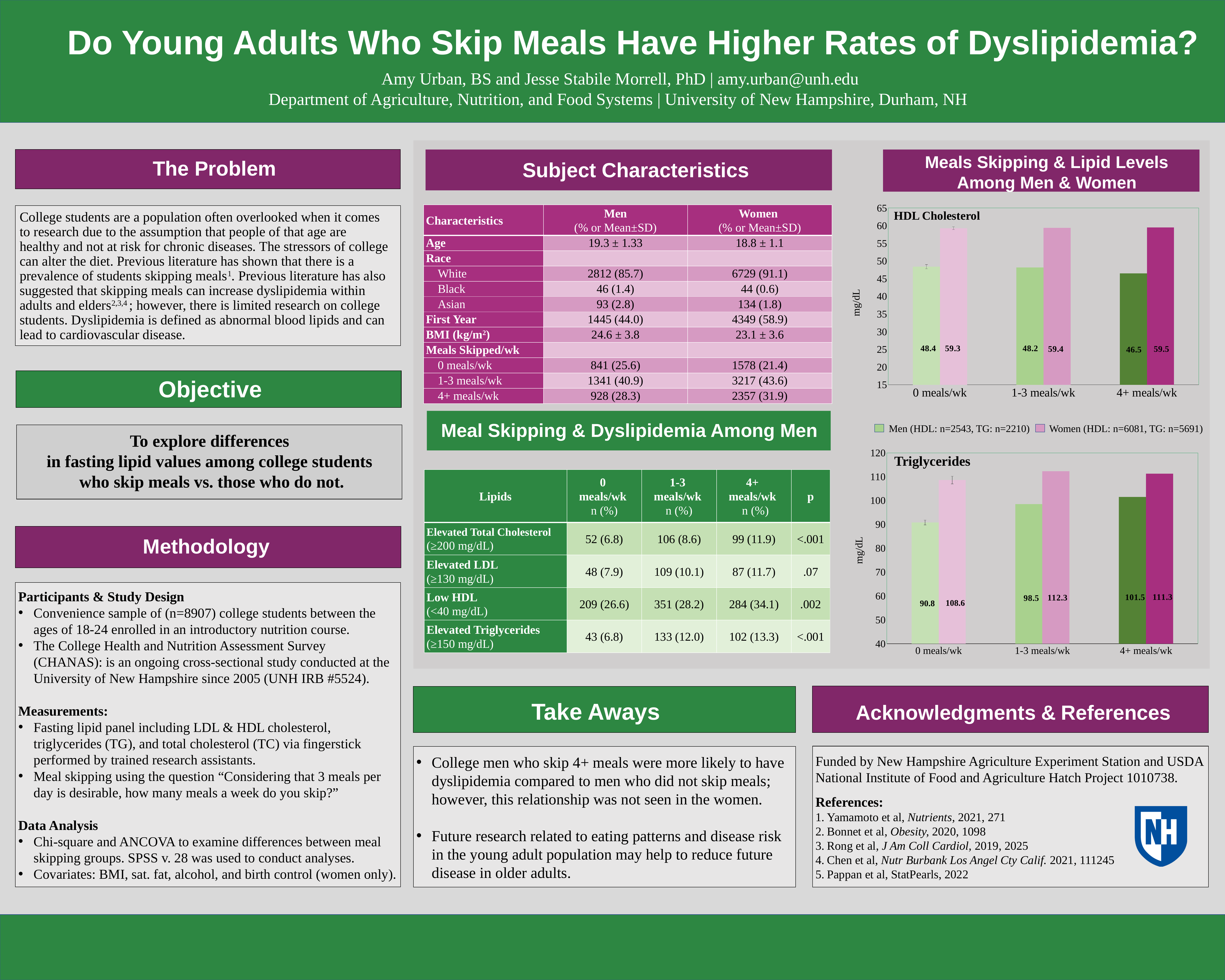
In the HDL Cholesterol chart, what is the value for men who skip 0 meals/wk? 48.4 In the Triglycerides chart, what is the value for women who skip 0 meals/wk? 108.6 What type of chart is the Triglycerides chart? Bar chart In the HDL Cholesterol chart, which meal-skipping group has the lowest value for men? 4+ meals/wk In the HDL Cholesterol chart, which is larger for 1-3 meals/wk: the men's value or the women's value? Women In the HDL Cholesterol chart, what is the value for women who skip 4+ meals/wk? 59.5 How many series does the legend list for the Meals Skipping & Lipid Levels charts? 2 In the Triglycerides chart, which meal-skipping group has the highest value for women? 1-3 meals/wk In the Triglycerides chart, is the men's value for 4+ meals/wk greater or less than 100? greater How many meal-skipping categories are shown on the x axis of the HDL Cholesterol chart? 3 In the Triglycerides chart, what is the difference between the women's and men's values for 0 meals/wk? 17.8 In the Triglycerides chart, what is the value for men who skip 1-3 meals/wk? 98.5